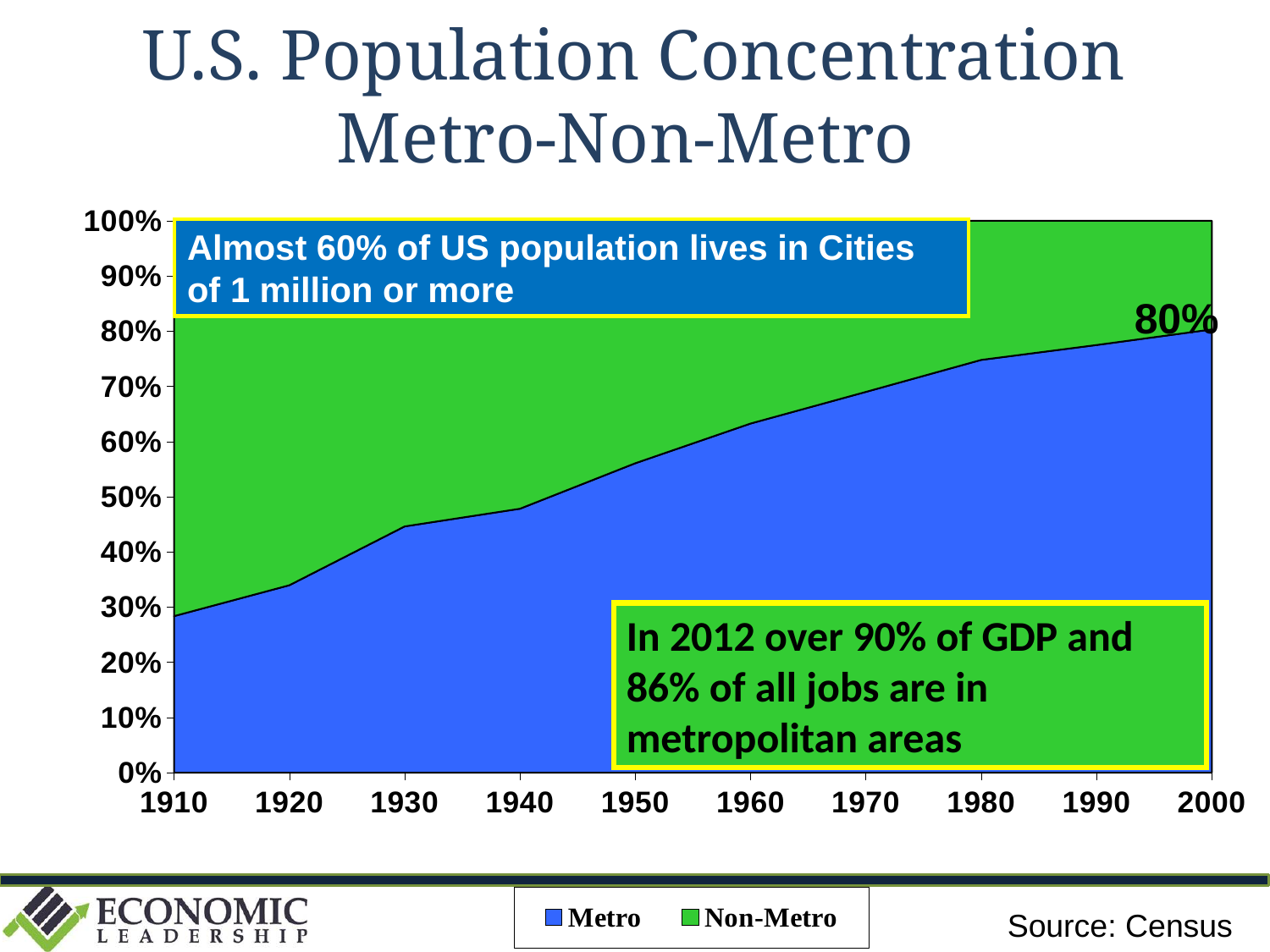
How many series does the legend list? 2 What is the Metro share of the U.S. population in 2000? 80% Does the Metro share rise or fall from 1910 to 2000? rise In which year is the Metro share highest? 2000 Is the Metro share in 1980 greater or less than 70%? greater In which year is the Metro share lowest? 1910 Is the Metro share in 1910 greater or less than 40%? less In 1910, which is larger: the Metro share or the Non-Metro share? Non-Metro How many years are labelled along the x axis? 10 In 2000, which is larger: the Metro share or the Non-Metro share? Metro Which colour represents the Non-Metro series in the legend? green What kind of chart is shown on the slide? area chart